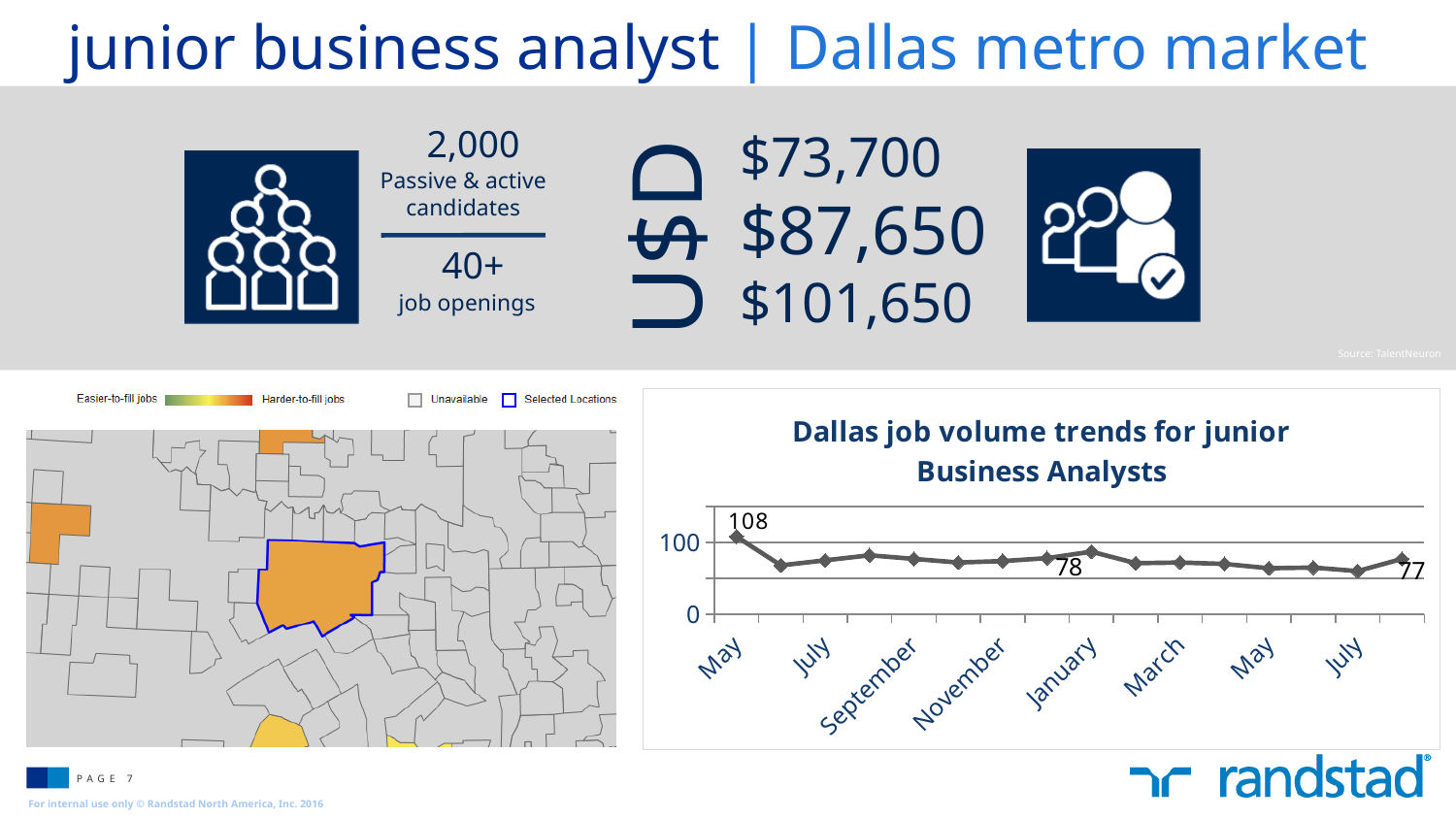
In the Dallas job volume trends chart, is the value for the first May greater or less than 100? greater How many month labels are shown on the x axis of the Dallas job volume trends chart? 8 What kind of chart is "Dallas job volume trends for junior Business Analysts"? line chart What is the highest tick value shown on the y axis of the Dallas job volume trends chart? 100 In the Dallas job volume trends chart, is the value at the last point greater or less than 100? less In the Dallas job volume trends chart, what is the value labeled at the first point (May)? 108 In the Dallas job volume trends chart, which month has the highest job volume? May (the first point) In the Dallas job volume trends chart, what value is labeled at the last point on the line? 77 In the Dallas job volume trends chart, do the values generally rise or fall from the first May to the end of the series? fall What is the title of the line chart on the slide? Dallas job volume trends for junior Business Analysts In the Dallas job volume trends chart, which is larger: the value at the first point or the value at the last point? the first point In the Dallas job volume trends chart, what is the difference between the first labeled value (108) and the last labeled value (77)? 31